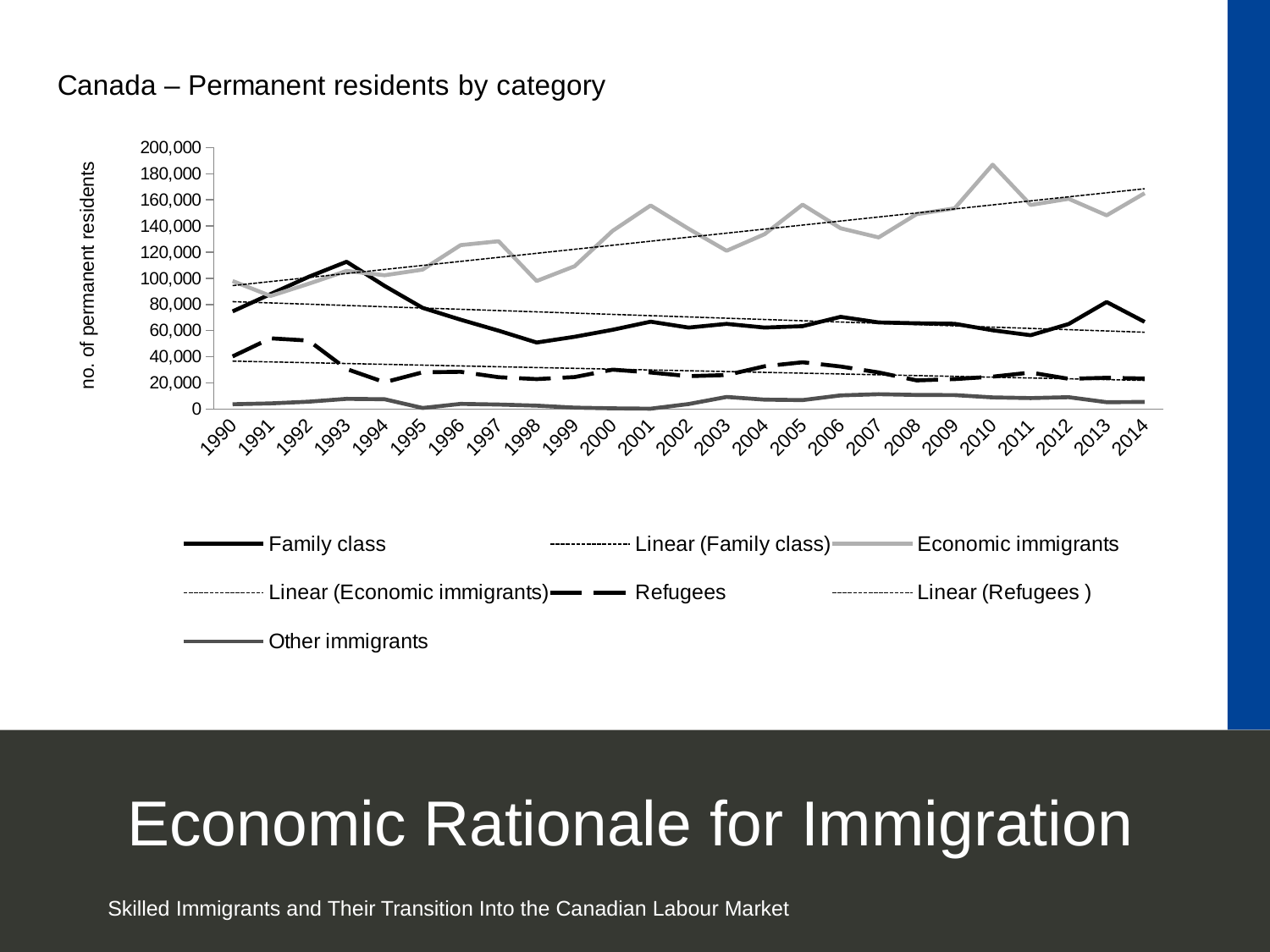
In which year does the Family class series reach its highest value? 1993 Is the value for Family class in 1993 greater or less than 100,000? greater What kind of chart is shown on the slide? line chart Does the linear trendline for Economic immigrants rise or fall from 1990 to 2014? rise Is the value for Refugees in 1991 greater or less than 40,000? greater Is the value for Economic immigrants in 1998 greater or less than 120,000? less What is the label on the vertical axis of the chart? no. of permanent residents How many entries does the chart's legend list? 7 How many years are plotted along the x axis of the chart? 25 In which year does the Economic immigrants series reach its highest value? 2010 In 2014, which is larger: Economic immigrants or Family class? Economic immigrants